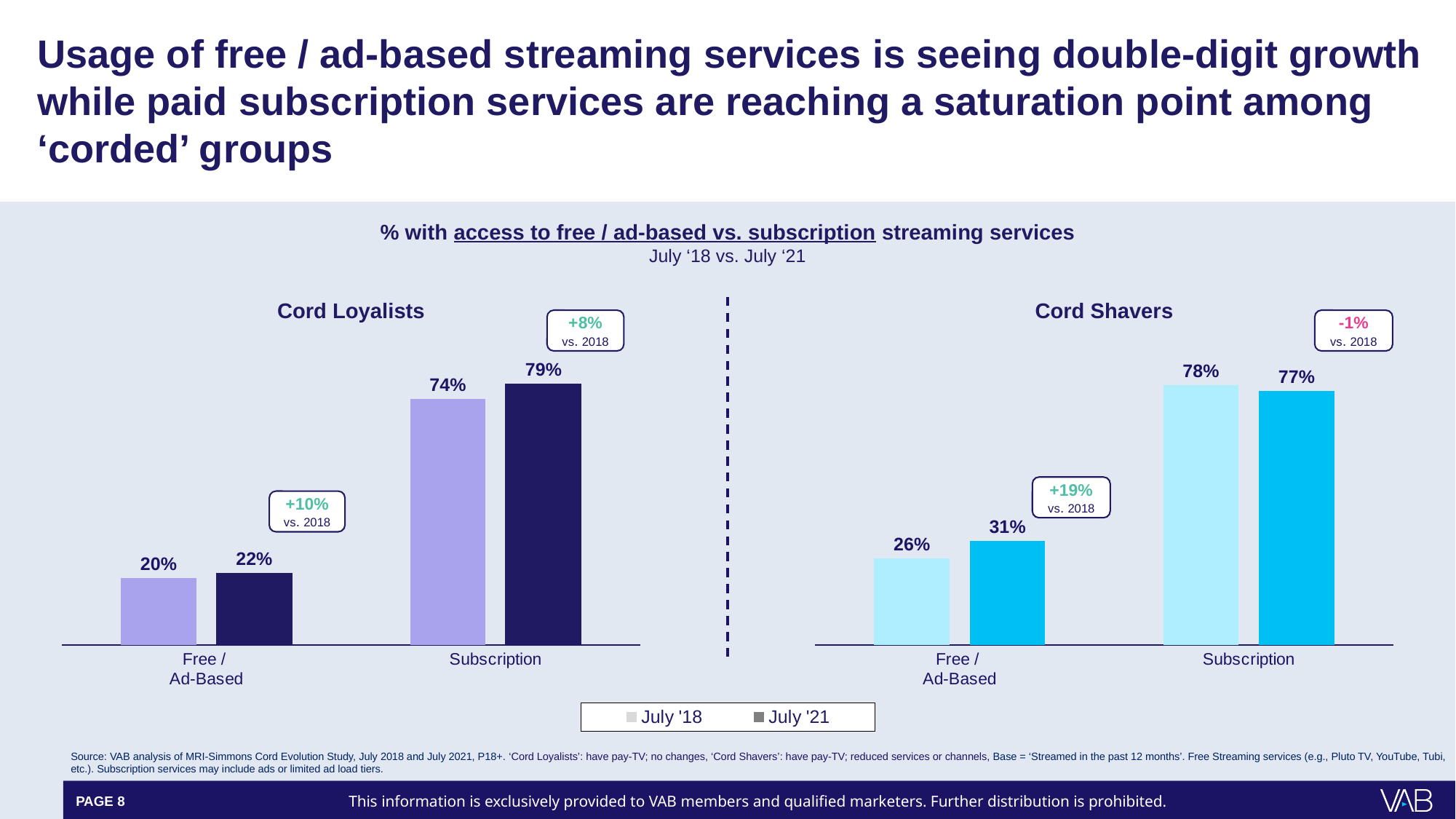
In the Cord Shavers chart, which category has the lowest July '18 value? Free / Ad-Based How many series does the legend list? 2 What kind of chart is the Cord Loyalists chart? Bar chart In the Cord Loyalists chart, what is the difference between the July '21 and July '18 values for Subscription? 5% In the Cord Shavers chart, what is the July '21 value for Free / Ad-Based? 31% In the Cord Shavers chart, is the July '18 or the July '21 value for Subscription larger? July '18 In the Cord Shavers chart, what is the July '18 value for Subscription? 78% In the Cord Shavers chart, what change vs. 2018 is shown in the callout above the Subscription bars? -1% In the Cord Loyalists chart, what is the July '18 value for Free / Ad-Based? 20% In the Cord Shavers chart, what is the difference between the July '21 and July '18 values for Free / Ad-Based? 5% In the Cord Loyalists chart, what is the July '21 value for Subscription? 79% In the Cord Loyalists chart, which category has the highest July '21 value? Subscription